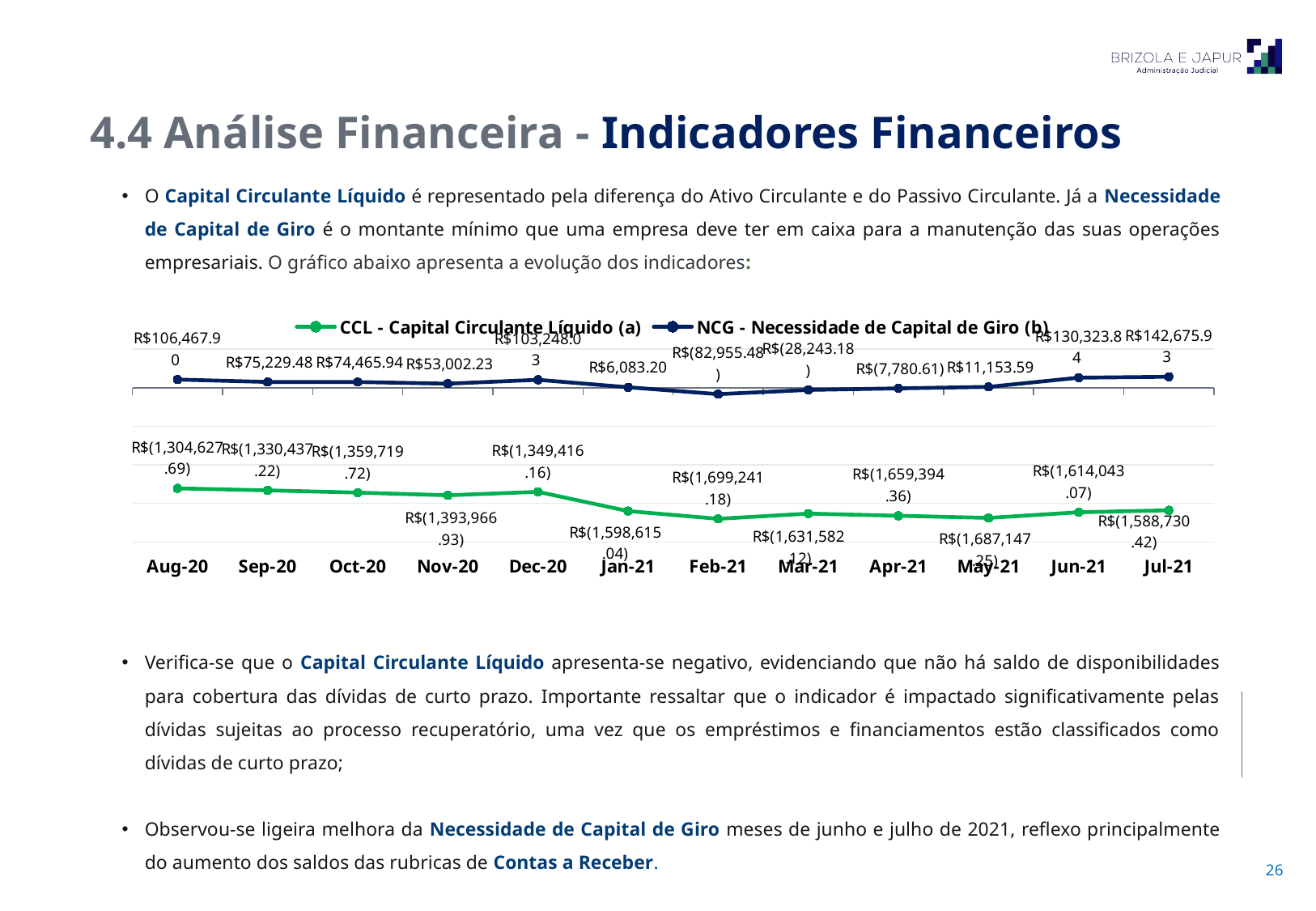
What is the value of CCL - Capital Circulante Líquido (a) for Feb-21? R$(1,699,241.18) Which month has a higher NCG value, Sep-20 or Oct-20? Sep-20 What is the difference between the NCG values for Jul-21 and Jun-21? R$12,352.09 What is the value of NCG - Necessidade de Capital de Giro (b) for Jan-21? R$6,083.20 In which month is CCL - Capital Circulante Líquido (a) lowest (most negative)? Feb-21 What is the value of NCG - Necessidade de Capital de Giro (b) for Nov-20? R$53,002.23 In which month is NCG - Necessidade de Capital de Giro (b) lowest? Feb-21 How many months are plotted on the x axis of the chart? 12 How many series does the chart legend list? 2 What type of chart is shown on the slide? Line chart In which month is NCG - Necessidade de Capital de Giro (b) highest? Jul-21 What is the value of NCG - Necessidade de Capital de Giro (b) for Sep-20? R$75,229.48